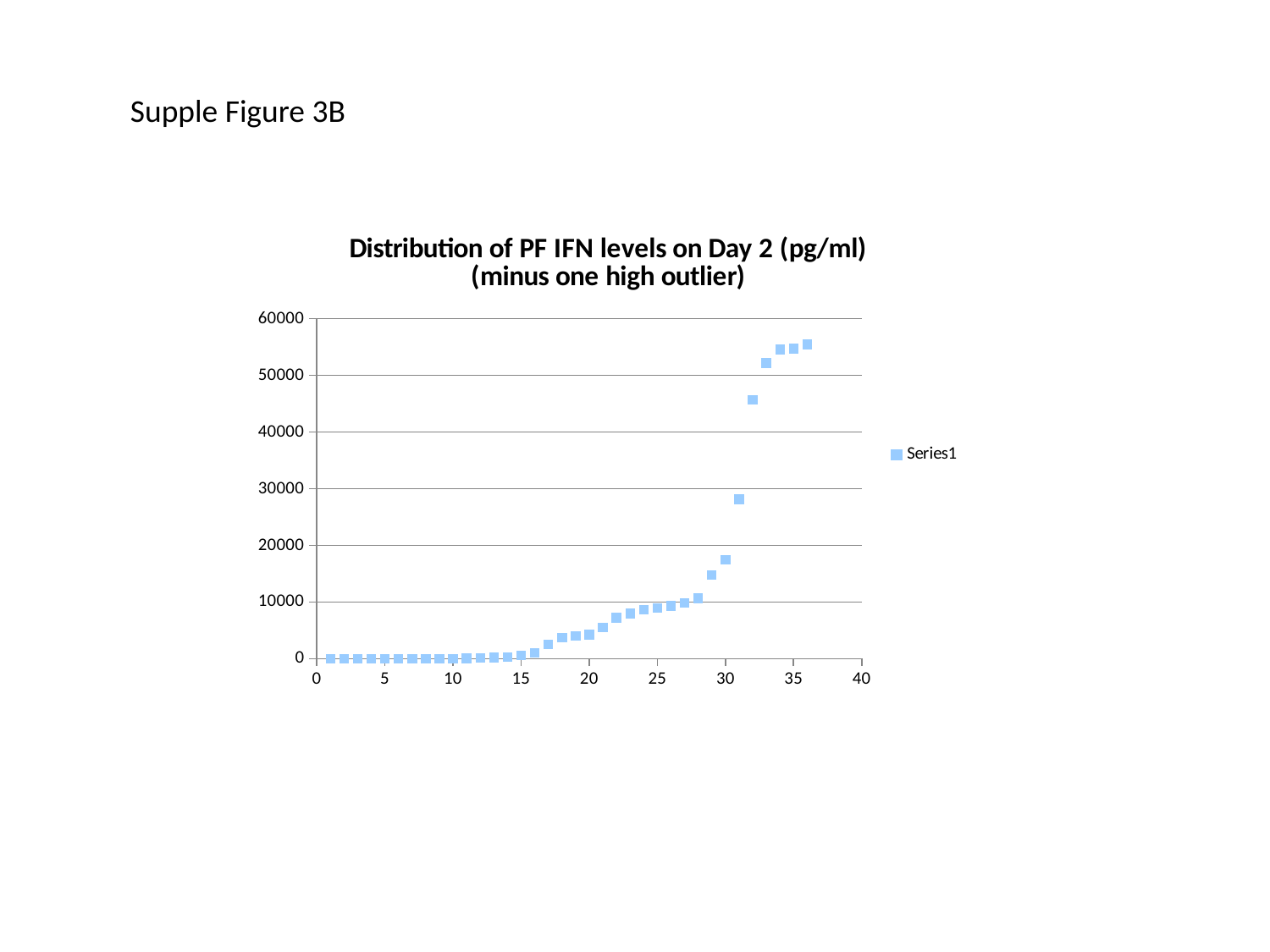
Is the value at x = 20 greater or less than 10000? less What is the name of the series shown in the legend? Series1 Is the value at x = 36 greater or less than 50000? greater Is the value at x = 30 greater or less than 20000? less What kind of chart is shown on the slide? scatter chart How many series does the legend list? 1 Do the values rise or fall as the x axis increases? rise What is the highest value shown on the y axis? 60000 What is the title of the chart? Distribution of PF IFN levels on Day 2 (pg/ml) (minus one high outlier) Which is larger, the value at x = 31 or the value at x = 33? x = 33